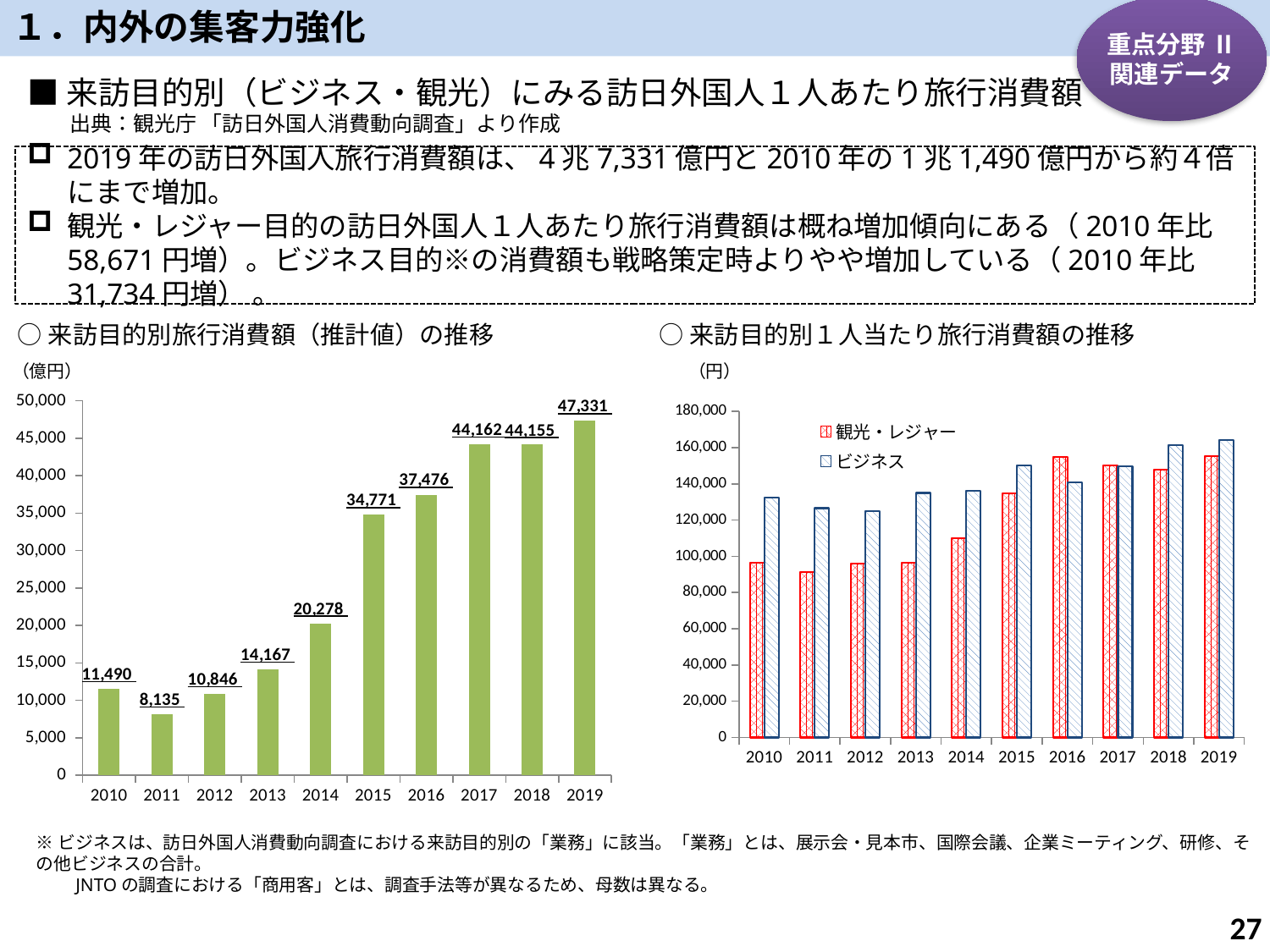
In the left chart (来訪目的別旅行消費額（推計値）の推移), what kind of chart is it? Bar chart In the left chart (来訪目的別旅行消費額（推計値）の推移), do the values generally rise or fall from 2011 to 2019? Rise In the left chart (来訪目的別旅行消費額（推計値）の推移), what is the value for 2019? 47,331 In the left chart (来訪目的別旅行消費額（推計値）の推移), what is the difference between the 2019 value and the 2010 value? 35,841 In the left chart (来訪目的別旅行消費額（推計値）の推移), which year has the lowest value? 2011 In the right chart (来訪目的別1人当たり旅行消費額の推移), which series has the larger value in 2010, 観光・レジャー or ビジネス? ビジネス In the right chart (来訪目的別1人当たり旅行消費額の推移), how many series does the legend list? 2 In the left chart (来訪目的別旅行消費額（推計値）の推移), which year has the highest value? 2019 In the left chart (来訪目的別旅行消費額（推計値）の推移), how many years are shown on the x axis? 10 In the right chart (来訪目的別1人当たり旅行消費額の推移), is the value for ビジネス in 2019 greater or less than 160,000? greater In the right chart (来訪目的別1人当たり旅行消費額の推移), is the value for 観光・レジャー in 2010 greater or less than 100,000? less In the left chart (来訪目的別旅行消費額（推計値）の推移), what is the value for 2011? 8,135